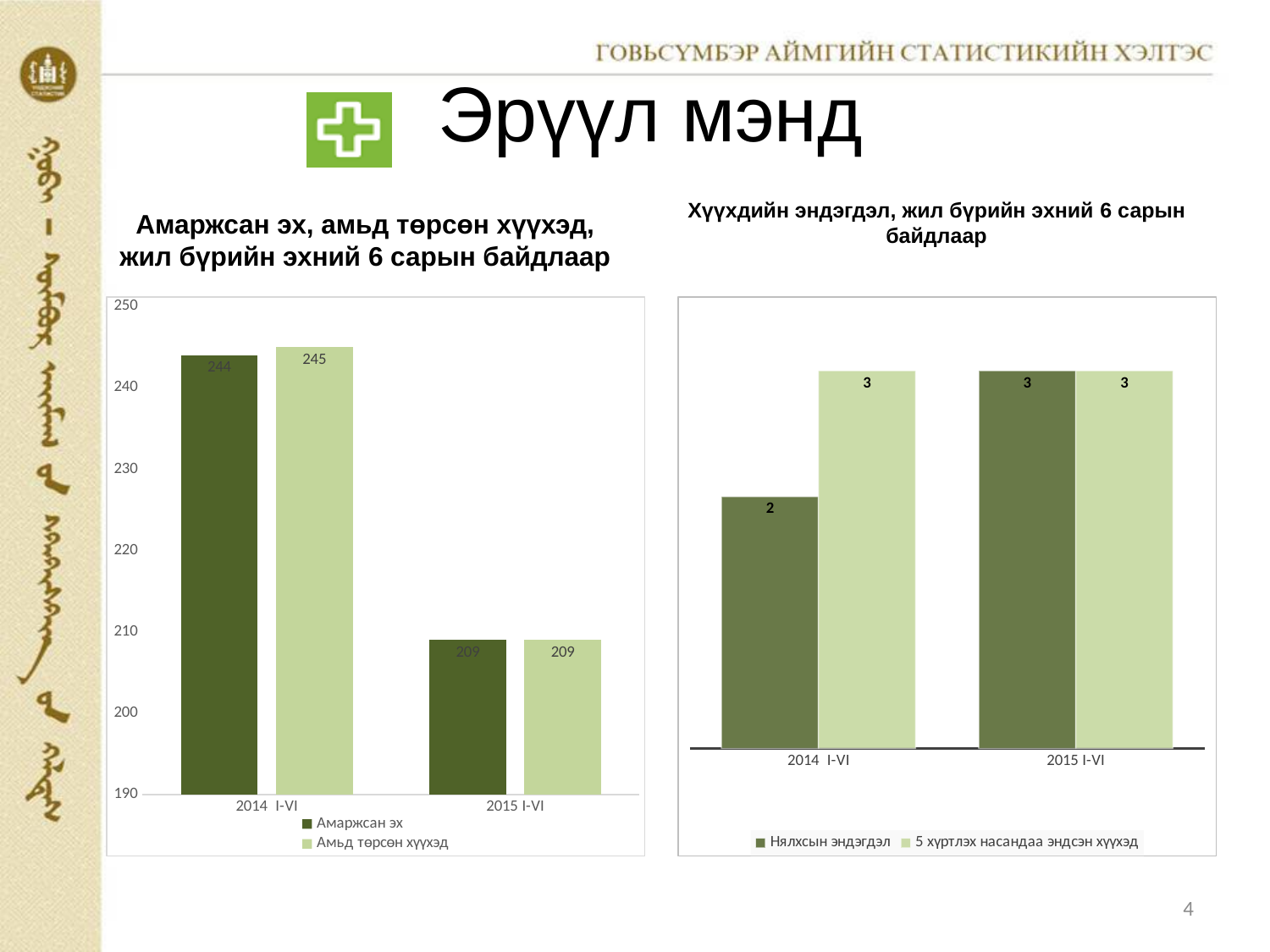
In the right chart (Хүүхдийн эндэгдэл), which is larger for 2014 I-VI: Нялхсын эндэгдэл or 5 хүртлэх насандаа эндсэн хүүхэд? 5 хүртлэх насандаа эндсэн хүүхэд In the left chart (Амаржсан эх, амьд төрсөн хүүхэд), is the value of Амаржсан эх for 2015 I-VI greater or less than 220? less In the right chart (Хүүхдийн эндэгдэл), how many categories are shown on the x axis? 2 In the left chart (Амаржсан эх, амьд төрсөн хүүхэд), does the value of Амаржсан эх rise or fall from 2014 I-VI to 2015 I-VI? fall In the right chart (Хүүхдийн эндэгдэл), what is the value of 5 хүртлэх насандаа эндсэн хүүхэд for 2015 I-VI? 3 In the left chart (Амаржсан эх, амьд төрсөн хүүхэд), what is the difference between Амьд төрсөн хүүхэд in 2014 I-VI and 2015 I-VI? 36 In the left chart (Амаржсан эх, амьд төрсөн хүүхэд), what is the value of Амьд төрсөн хүүхэд for 2015 I-VI? 209 In the left chart (Амаржсан эх, амьд төрсөн хүүхэд), how many series does the legend list? 2 In the left chart (Амаржсан эх, амьд төрсөн хүүхэд), what is the value of Амаржсан эх for 2014 I-VI? 244 In the right chart (Хүүхдийн эндэгдэл), what is the value of Нялхсын эндэгдэл for 2014 I-VI? 2 What type of chart is the right chart (Хүүхдийн эндэгдэл)? bar chart What is the title of the right chart? Хүүхдийн эндэгдэл, жил бүрийн эхний 6 сарын байдлаар